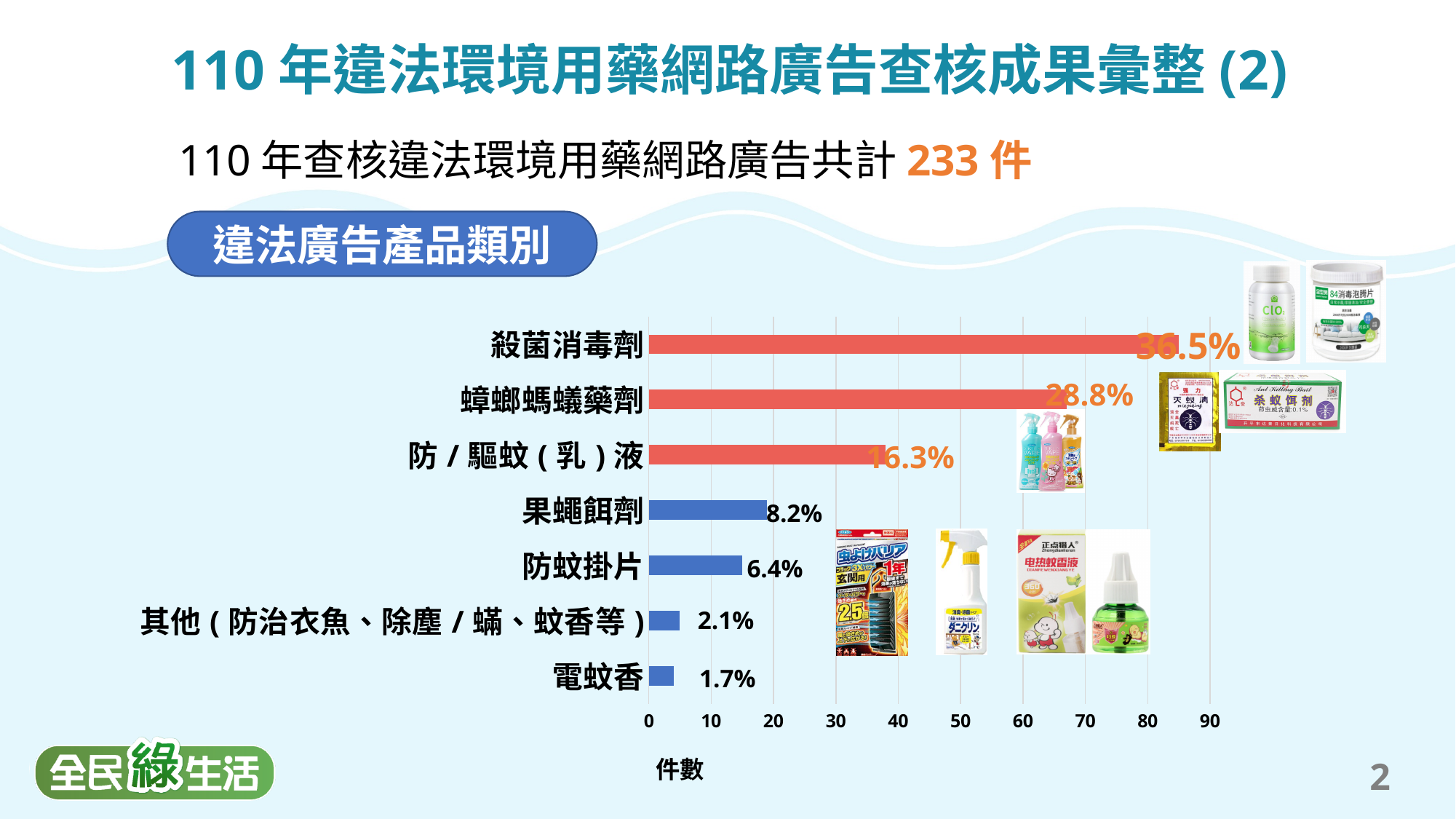
How many product categories are shown in the bar chart? 7 Which product category has the lowest value in the chart? 電蚊香 What percentage label is shown for 電蚊香? 1.7% What type of chart is shown on the slide? bar chart What percentage label is shown for 殺菌消毒劑? 36.5% What percentage label is shown for 蟑螂螞蟻藥劑? 28.8% What is the label of the x axis of the chart? 件數 What is the difference in percentage points between 殺菌消毒劑 and 蟑螂螞蟻藥劑? 7.7 Is the number of cases (件數) for 殺菌消毒劑 greater or less than 80? greater Which product category has the highest value in the chart? 殺菌消毒劑 Which has a larger value, 果蠅餌劑 or 防蚊掛片? 果蠅餌劑 What percentage label is shown for 防蚊掛片? 6.4%